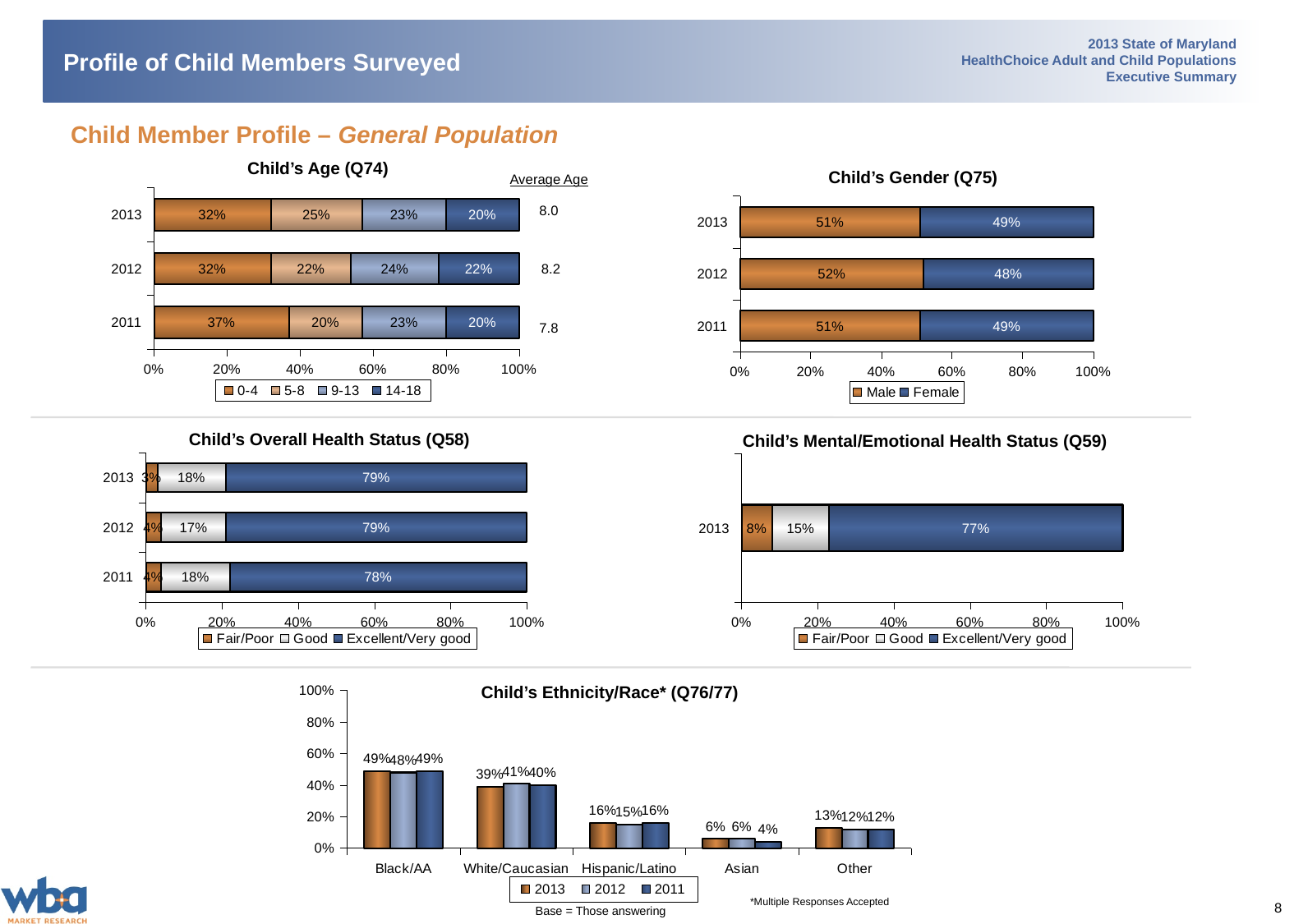
In the Child's Ethnicity/Race (Q76/77) chart, how many ethnicity categories are shown on the x axis? 5 In the Child's Mental/Emotional Health Status (Q59) chart, what percentage of children in 2013 were rated Fair/Poor? 8% In the Child's Ethnicity/Race (Q76/77) chart, which ethnicity category has the highest value for 2013? Black/AA In the Child's Age (Q74) chart, what is the average age shown for 2012? 8.2 In the Child's Age (Q74) chart, how many series does the legend list? 4 In the Child's Overall Health Status (Q58) chart, what percentage of children in 2011 were rated Excellent/Very good? 78% In the Child's Ethnicity/Race (Q76/77) chart, what is the 2011 value for Asian? 4% In the Child's Gender (Q75) chart, what percentage of children surveyed in 2012 were male? 52% In the Child's Gender (Q75) chart, what is the difference between the male and female shares in 2013? 2% In the Child's Age (Q74) chart, what percentage of children surveyed in 2013 were aged 0-4? 32% In the Child's Ethnicity/Race (Q76/77) chart, what kind of chart is shown? Bar chart In the Child's Overall Health Status (Q58) chart, which year has the highest Good percentage, 2012 or 2013? 2013